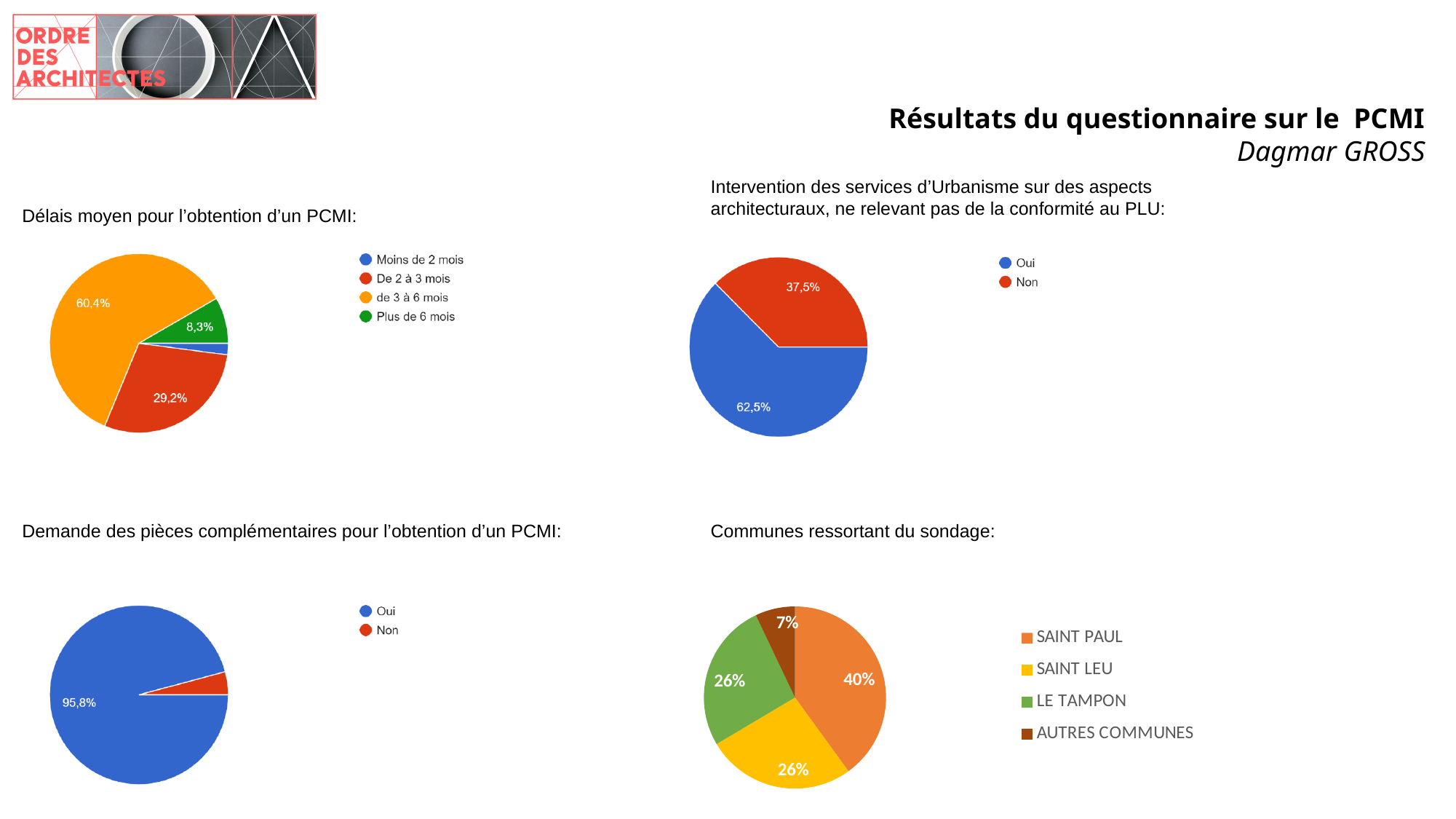
In the chart 'Demande des pièces complémentaires pour l'obtention d'un PCMI', which answer is larger, 'Oui' or 'Non'? Oui In the chart 'Délais moyen pour l'obtention d'un PCMI', what share is shown for 'de 3 à 6 mois'? 60,4% In the chart 'Délais moyen pour l'obtention d'un PCMI', how many categories does the legend list? 4 In the chart 'Délais moyen pour l'obtention d'un PCMI', what share is shown for 'Plus de 6 mois'? 8,3% In the chart 'Communes ressortant du sondage', which commune has the smallest share? AUTRES COMMUNES In the chart 'Communes ressortant du sondage', what share is shown for SAINT PAUL? 40% In the chart 'Intervention des services d'Urbanisme sur des aspects architecturaux', what is the difference between the 'Oui' and 'Non' shares? 25 percentage points In the chart 'Délais moyen pour l'obtention d'un PCMI', which category has the smallest slice? Moins de 2 mois In the chart 'Délais moyen pour l'obtention d'un PCMI', which category has the largest slice? de 3 à 6 mois In the chart 'Demande des pièces complémentaires pour l'obtention d'un PCMI', what share answered 'Oui'? 95,8% What type of chart is used for 'Communes ressortant du sondage'? Pie chart In the chart 'Intervention des services d'Urbanisme sur des aspects architecturaux', what share answered 'Oui'? 62,5%